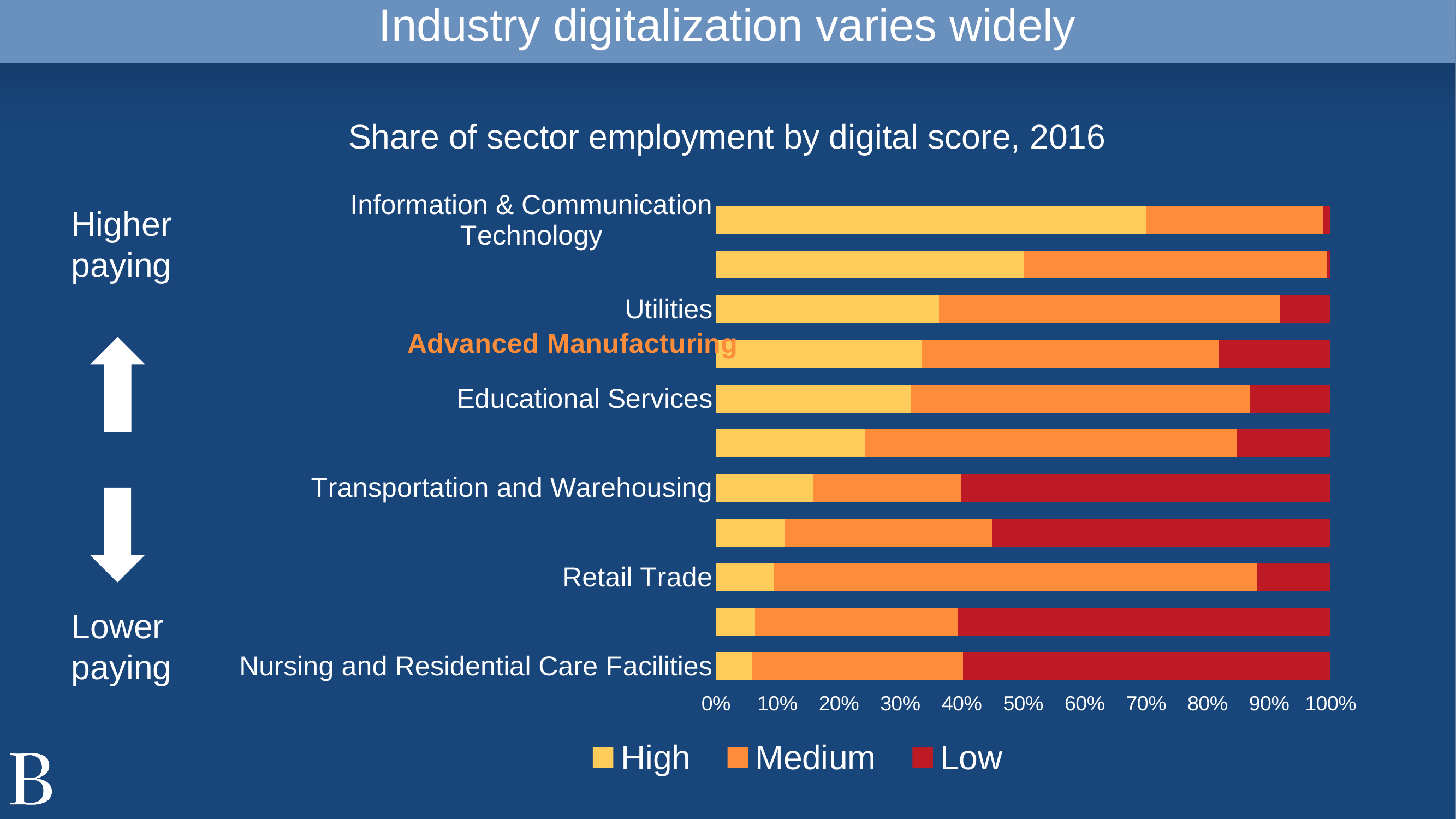
Which has the larger Low share, Transportation and Warehousing or Retail Trade? Transportation and Warehousing Which labeled sector has the largest High share? Information & Communication Technology What are the three series named in the legend? High, Medium, Low How many series does the legend list? 3 Is the High share for Information & Communication Technology greater or less than 60%? greater Is the Low share for Transportation and Warehousing greater or less than 50%? greater Which has the larger High share, Information & Communication Technology or Utilities? Information & Communication Technology What is the title of the chart? Share of sector employment by digital score, 2016 Is the High share for Nursing and Residential Care Facilities greater or less than 10%? less How many bars are plotted in the chart? 11 What kind of chart is shown on the slide? Stacked bar chart